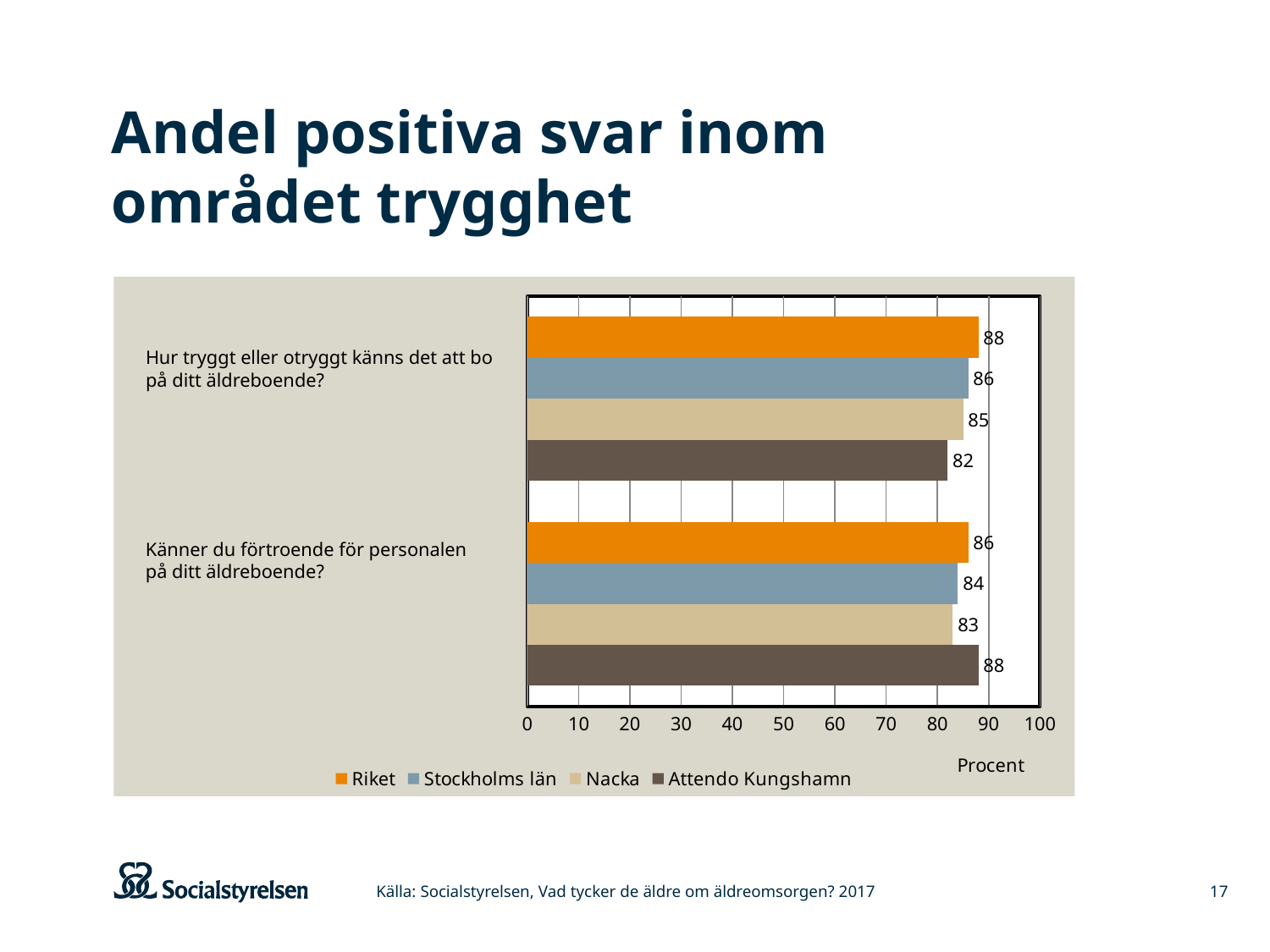
What unit label is shown on the horizontal axis of the chart? Procent For the question "Känner du förtroende för personalen på ditt äldreboende?", which is larger: the value for Riket or the value for Nacka? Riket How many series does the legend list? 4 What is the value for Riket for the question "Hur tryggt eller otryggt känns det att bo på ditt äldreboende?"? 88 Which series has the highest value for the question "Känner du förtroende för personalen på ditt äldreboende?"? Attendo Kungshamn Which series has the lowest value for the question "Hur tryggt eller otryggt känns det att bo på ditt äldreboende?"? Attendo Kungshamn How many questions (categories) are shown on the chart? 2 What is the difference between the Riket value and the Attendo Kungshamn value for the question "Hur tryggt eller otryggt känns det att bo på ditt äldreboende?"? 6 What is the value for Stockholms län for the question "Känner du förtroende för personalen på ditt äldreboende?"? 84 What kind of chart is shown on the slide? Bar chart What is the value for Attendo Kungshamn for the question "Känner du förtroende för personalen på ditt äldreboende?"? 88 What is the value for Nacka for the question "Hur tryggt eller otryggt känns det att bo på ditt äldreboende?"? 85